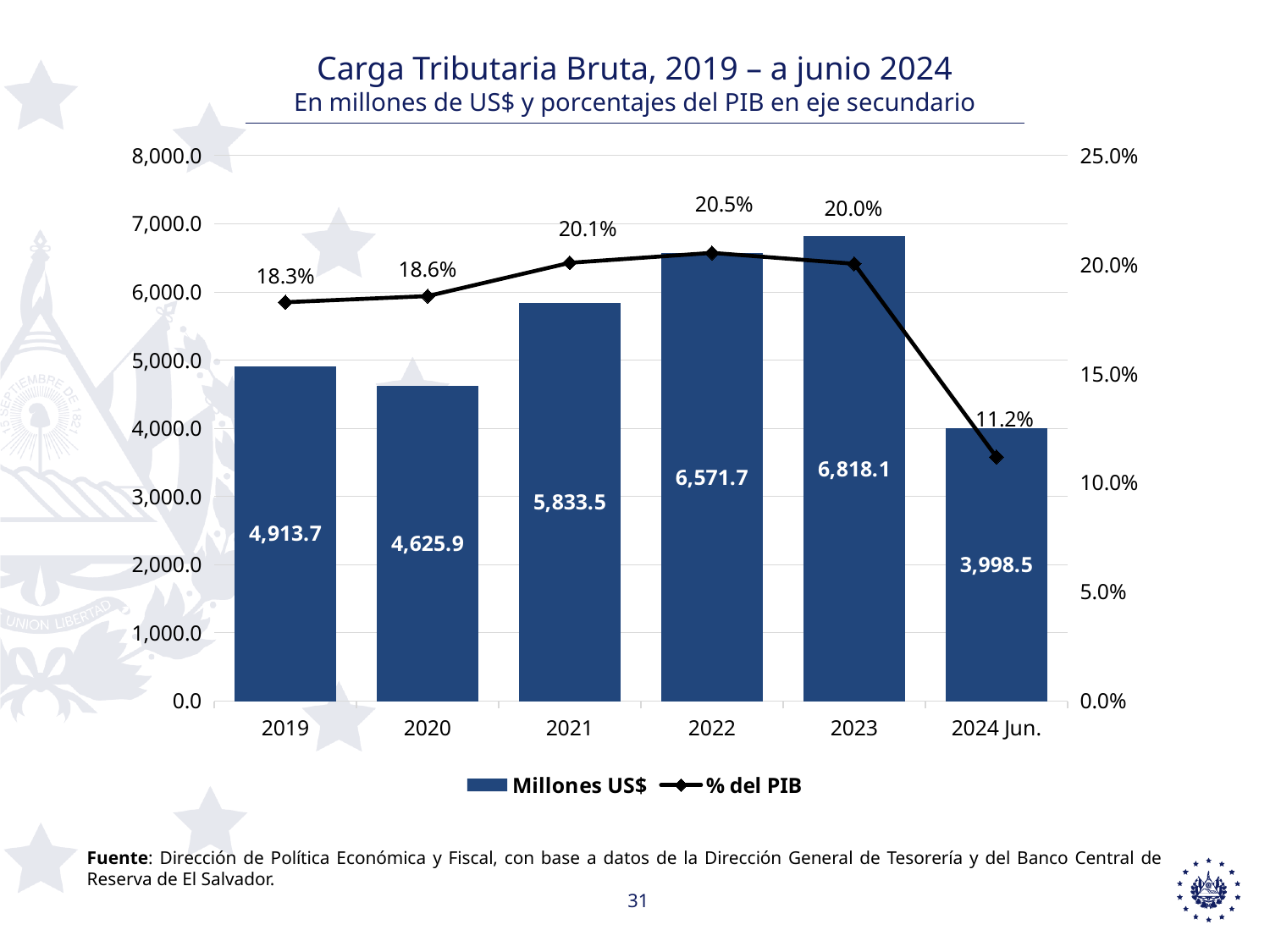
Does the % del PIB series rise or fall from 2019 to 2022? Rise Which is larger, the Millones US$ value for 2019 or for 2020? 2019 What is the difference in Millones US$ between 2023 and 2022? 246.4 What is the value of Millones US$ for 2021? 5,833.5 What kind of chart is used for the Millones US$ series? Bar chart Which category has the lowest % del PIB value? 2024 Jun. What is the value of Millones US$ for 2024 Jun.? 3,998.5 What is the title of the chart? Carga Tributaria Bruta, 2019 – a junio 2024 What is the % del PIB value for 2022? 20.5% How many categories are shown on the x axis? 6 Which year has the highest Millones US$ value? 2023 How many series does the legend list? 2